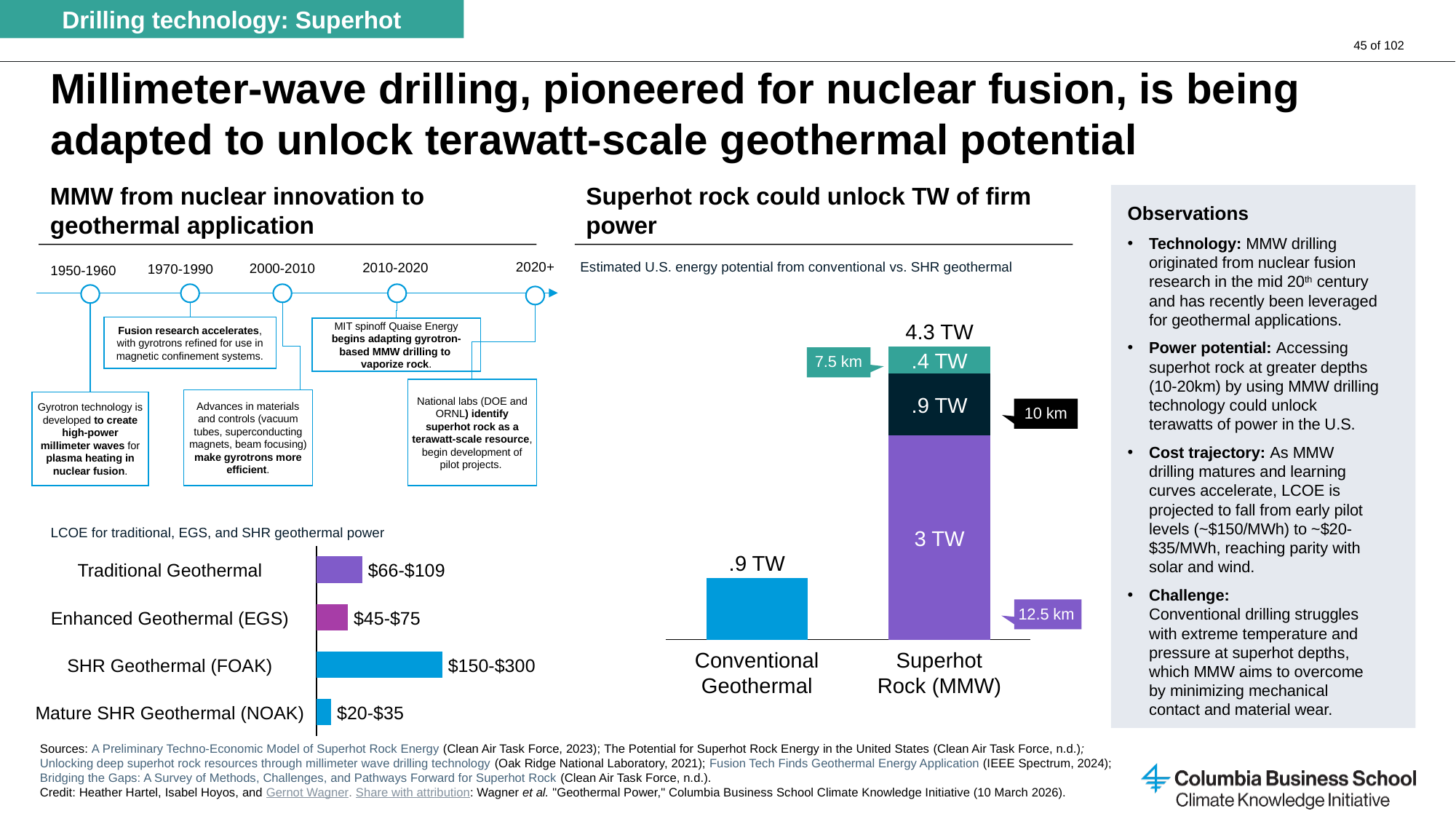
What kind of chart is the LCOE for traditional, EGS, and SHR geothermal power chart? Bar chart In the 'Superhot rock could unlock TW of firm power' chart, what is the value of the 12.5 km segment of the Superhot Rock (MMW) bar? 3 TW In the 'Superhot rock could unlock TW of firm power' chart, which is larger: Conventional Geothermal or Superhot Rock (MMW)? Superhot Rock (MMW) In the LCOE chart, which category has the highest LCOE? SHR Geothermal (FOAK) In the LCOE chart, which category has the lowest LCOE? Mature SHR Geothermal (NOAK) In the 'Superhot rock could unlock TW of firm power' chart, what is the difference between the Superhot Rock (MMW) total and the Conventional Geothermal value? 3.4 TW In the LCOE chart, what is the LCOE range shown for Traditional Geothermal? $66-$109 In the LCOE chart, what is the LCOE range shown for Mature SHR Geothermal (NOAK)? $20-$35 In the LCOE chart, what is the LCOE range shown for Enhanced Geothermal (EGS)? $45-$75 How many categories are shown in the LCOE chart? 4 In the 'Superhot rock could unlock TW of firm power' chart, what is the estimated energy potential for Conventional Geothermal? .9 TW In the 'Superhot rock could unlock TW of firm power' chart, what is the total energy potential for Superhot Rock (MMW)? 4.3 TW